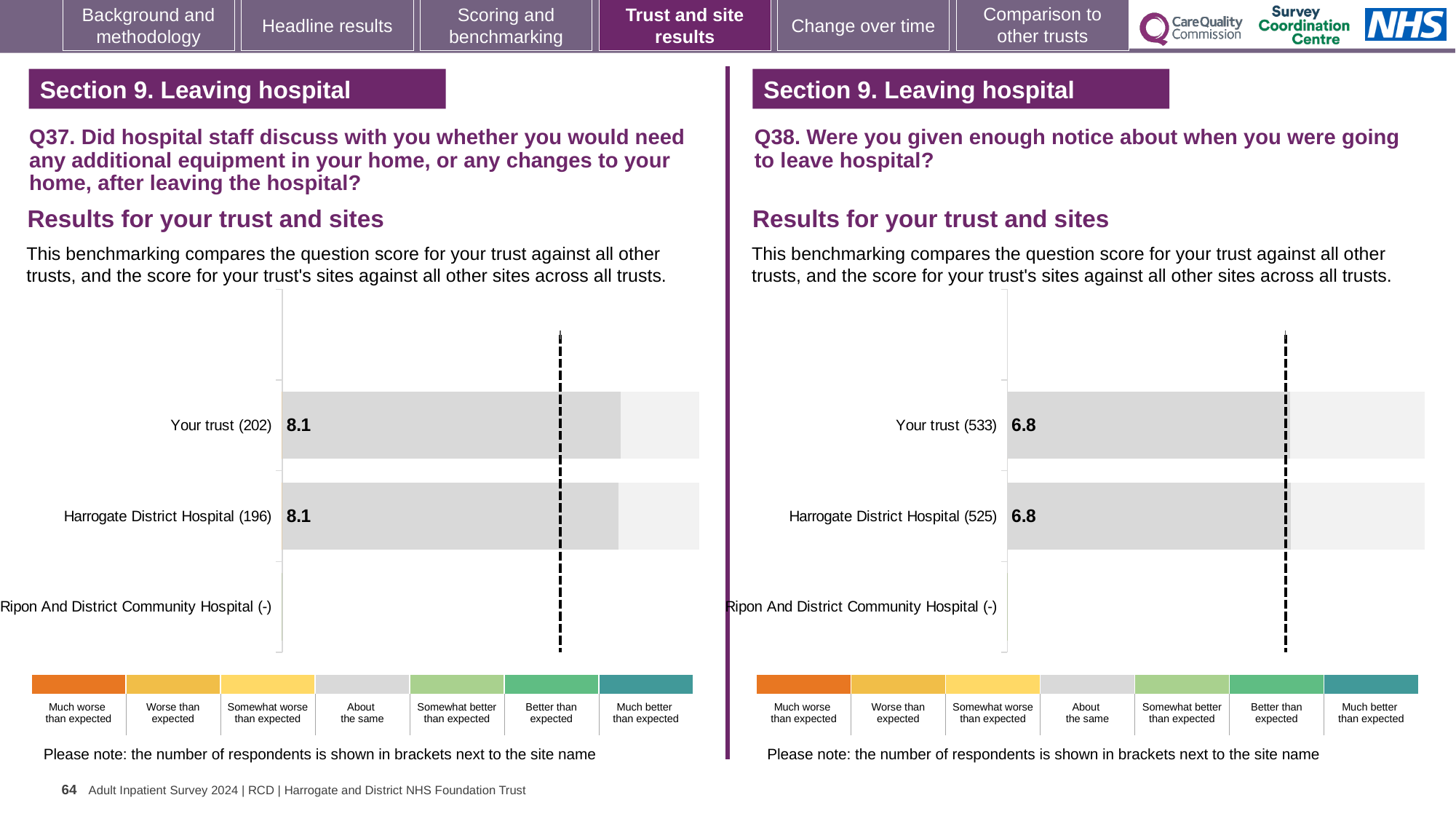
In the Q37 chart on the left, what is the difference between the score for Your trust and the score for Harrogate District Hospital? 0 In the Q38 chart on the right, how many respondents are shown in brackets for Harrogate District Hospital? 525 In the Q37 chart on the left, how many sites or categories are listed on the vertical axis? 3 What kind of chart is used in the Q37 chart on the left? Bar chart In the Q38 chart on the right, what is the score for Your trust? 6.8 In the Q38 chart on the right, what is the score for Harrogate District Hospital? 6.8 In the Q37 chart on the left, how many respondents are shown in brackets for Your trust? 202 In the Q38 chart on the right, how many sites or categories are listed on the vertical axis? 3 In the Q37 chart on the left, what is the score for Harrogate District Hospital? 8.1 Which is larger: the score for Your trust in the Q37 chart on the left or the score for Your trust in the Q38 chart on the right? Q37 chart (Your trust) In the Q37 chart on the left, what is the score for Your trust? 8.1